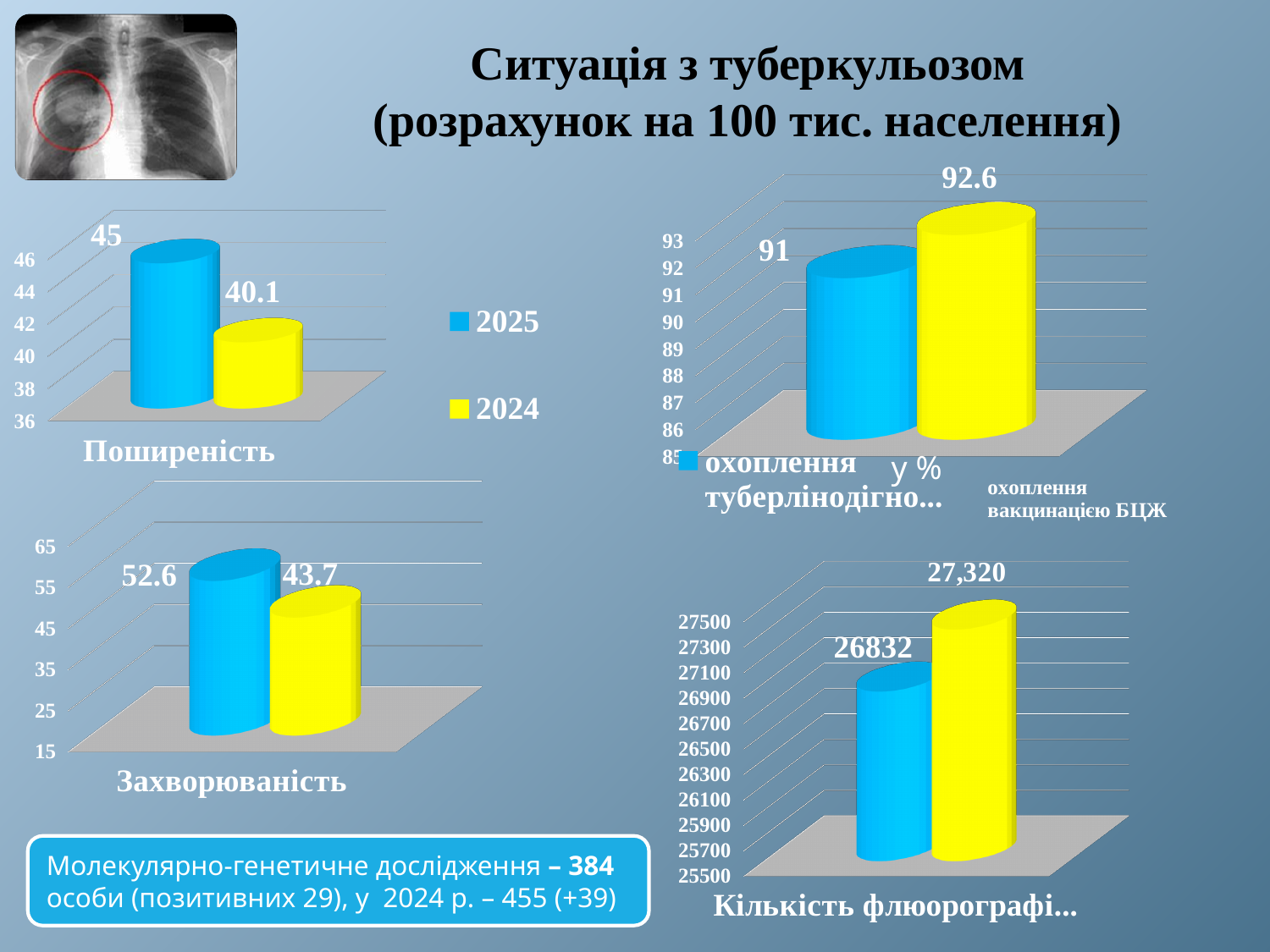
How many series does the legend on the slide list? 2 In the 'Кількість флюорографі...' chart, which year has the higher value? 2024 In the 'Захворюваність' chart, what is the value for 2025? 52.6 In the 'Захворюваність' chart, what is the value for 2024? 43.7 In the 'Кількість флюорографі...' chart, what is the value for 2025? 26832 In the 'Поширеність' chart, what is the value for 2025? 45 In the 'Поширеність' chart, what is the value for 2024? 40.1 In the 'Кількість флюорографі...' chart, what is the value for 2024? 27,320 In the 'Поширеність' chart, what is the difference between the 2025 and 2024 values? 4.9 In the 'Захворюваність' chart, which year has the larger value, 2025 or 2024? 2025